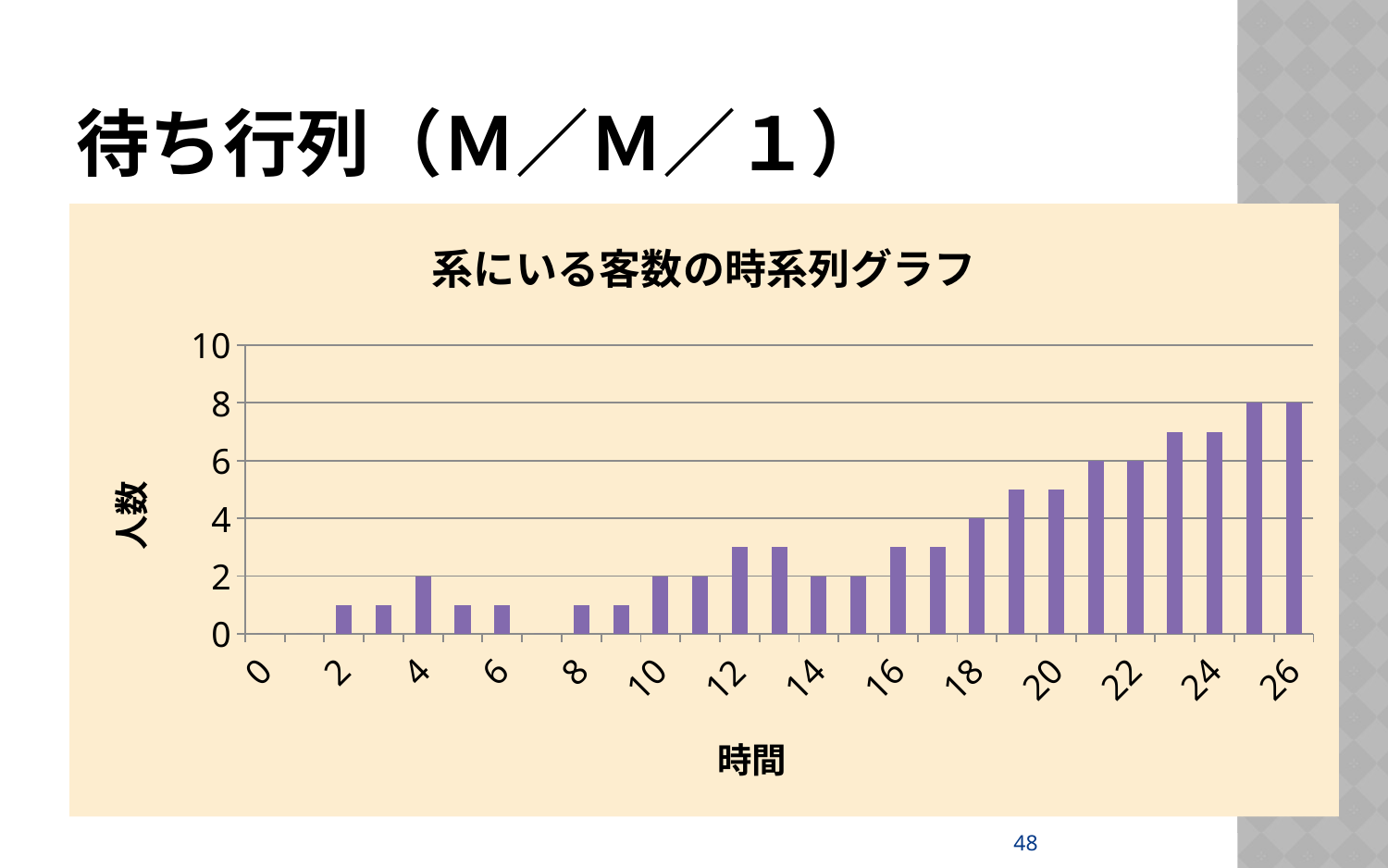
What is the difference between the value at 時間 = 26 and the value at 時間 = 4? 6 Is the value at 時間 = 12 greater or less than 2? greater What is the value (人数) at 時間 = 18? 4 What is the value (人数) at 時間 = 26? 8 What is the label of the vertical axis? 人数 What is the value (人数) at 時間 = 22? 6 Is the value at 時間 = 19 greater or less than 4? greater What is the title of the chart? 系にいる客数の時系列グラフ Do the values generally rise or fall as 時間 increases from 0 to 26? rise Which is larger, the value at 時間 = 22 or the value at 時間 = 10? 時間 = 22 What kind of chart is shown on the slide? bar chart What is the value (人数) at 時間 = 4? 2